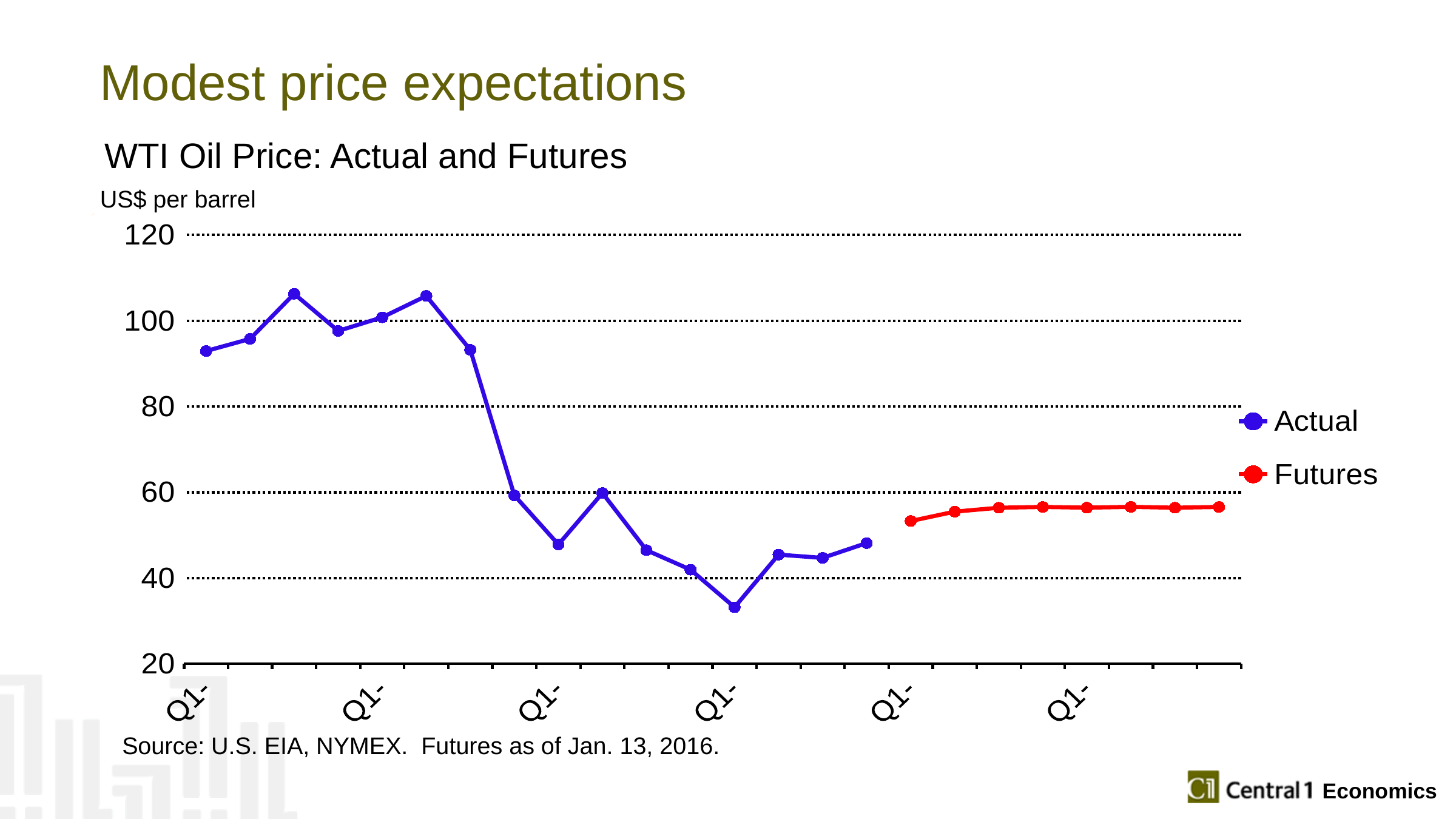
What unit is the y axis measured in, according to the label above the chart? US$ per barrel Does the Actual series end higher or lower than it starts? Lower How many data points are plotted for the Futures series? 8 What kind of chart is shown on the slide? Line chart How many series does the legend list? 2 Is the last point of the Futures series greater or less than 60? less Which series reaches the highest value on the chart? Actual Is the value of the first point of the Actual series greater or less than 80? greater Is the highest point of the Actual series greater or less than 100? greater Which is higher: the last point of the Actual series or the last point of the Futures series? Futures What are the two series named in the legend? Actual and Futures